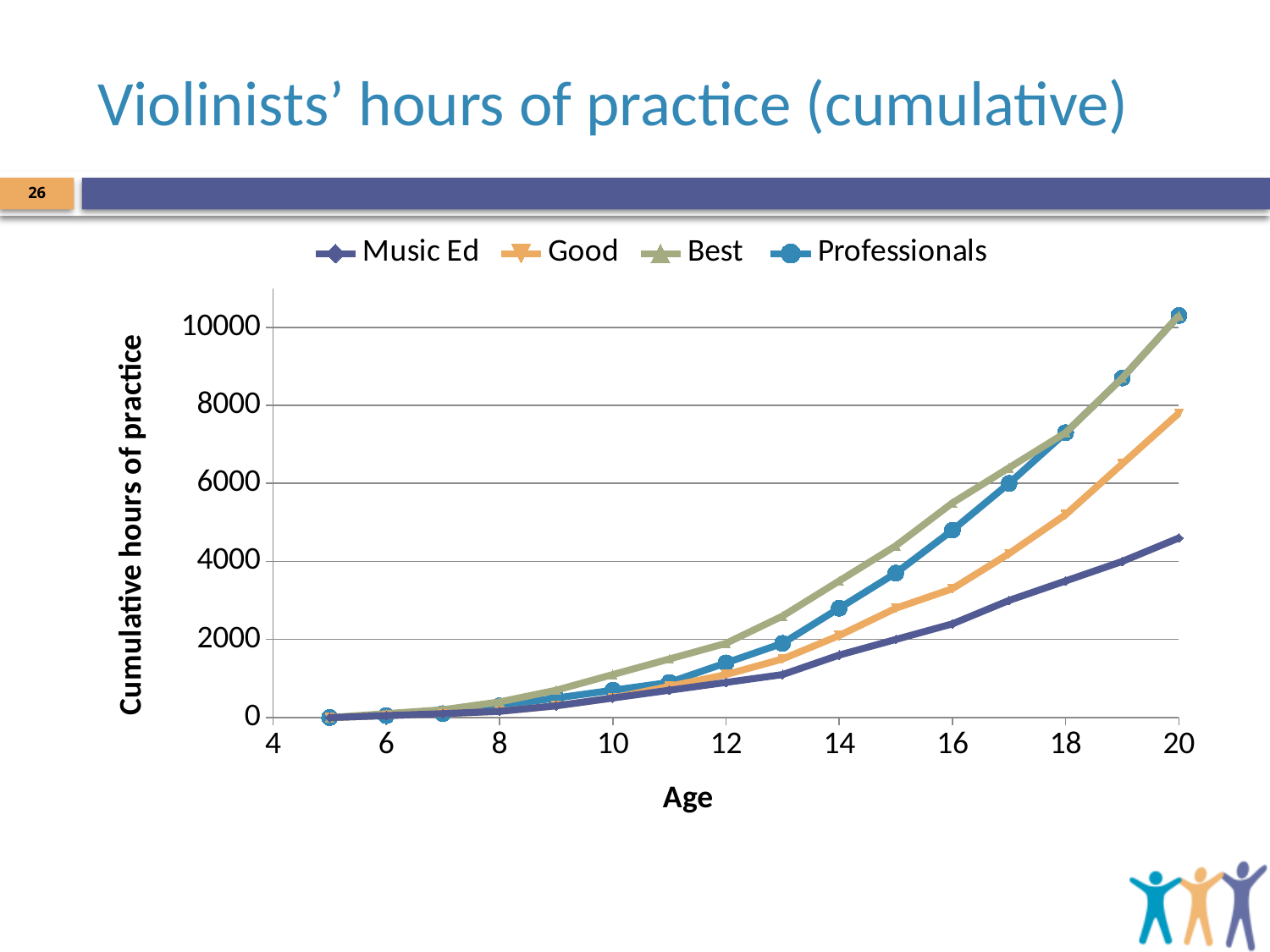
At age 20, which series has the lowest cumulative hours of practice? Music Ed How many series does the legend list? 4 At age 16, which is larger, the value for Best or the value for Professionals? Best Is the value for Professionals at age 18 greater or less than 6000? greater Is the value for Good at age 20 greater or less than 6000? greater Do the cumulative hours for Music Ed rise or fall as age increases? rise Is the value for Professionals at age 16 greater or less than 4000? greater What kind of chart is shown on the slide? line chart What is the title of the chart? Violinists' hours of practice (cumulative) What is the label on the vertical axis? Cumulative hours of practice At age 20, which is larger, the value for Music Ed or the value for Good? Good